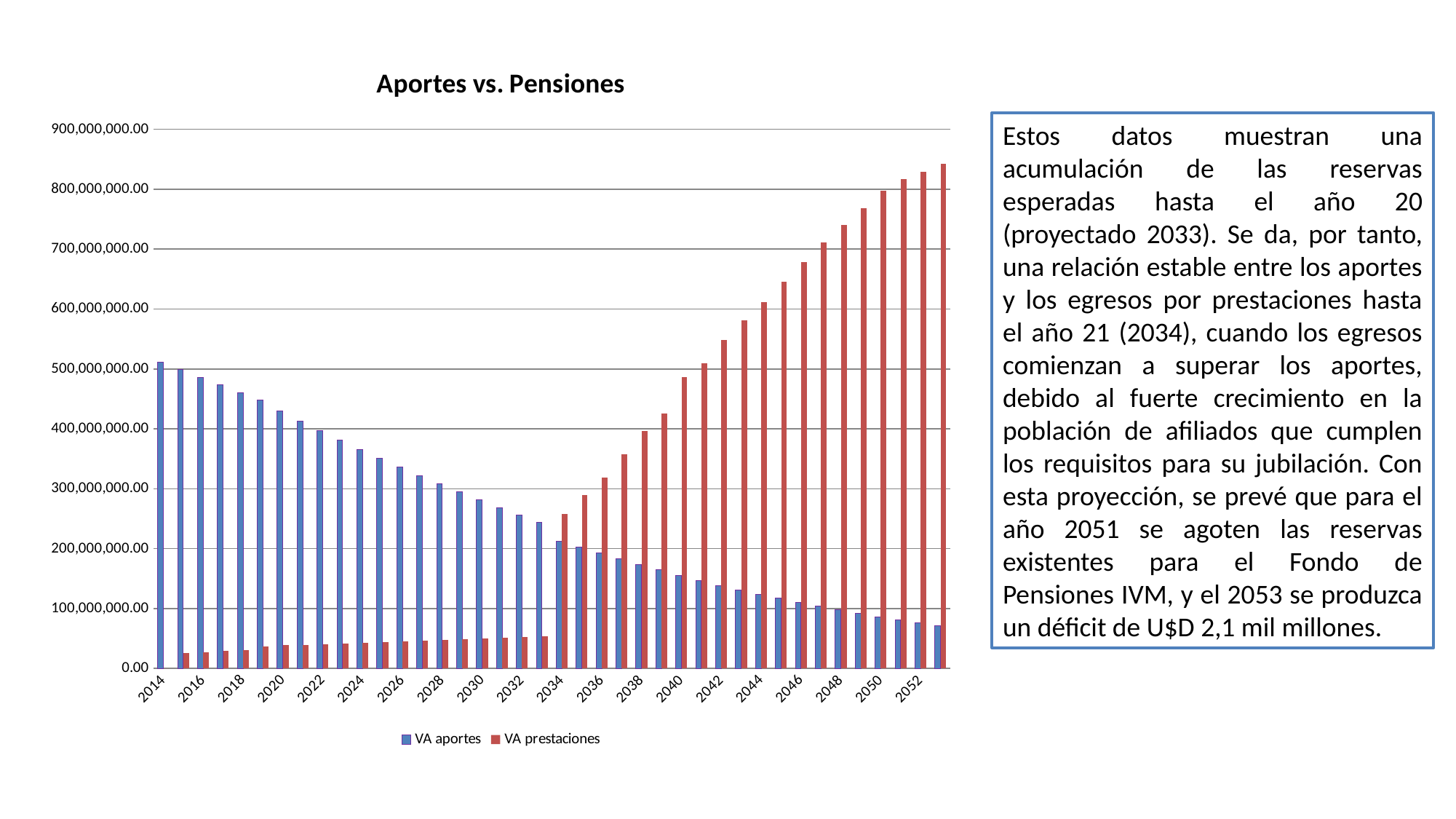
In which year is VA prestaciones lowest? 2014 In 2052, which is larger, VA aportes or VA prestaciones? VA prestaciones What are the two series named in the legend? VA aportes and VA prestaciones How many series does the chart's legend list? 2 Do the values for VA aportes rise or fall from 2014 to 2052? fall Is the value for VA aportes in 2030 greater or less than 300,000,000.00? less Is the value for VA prestaciones in 2052 greater or less than 800,000,000.00? greater In 2014, which is larger, VA aportes or VA prestaciones? VA aportes What is the title of the chart? Aportes vs. Pensiones In which year is VA aportes highest? 2014 Do the values for VA prestaciones rise or fall from 2014 to 2052? rise What kind of chart is shown on the slide? bar chart